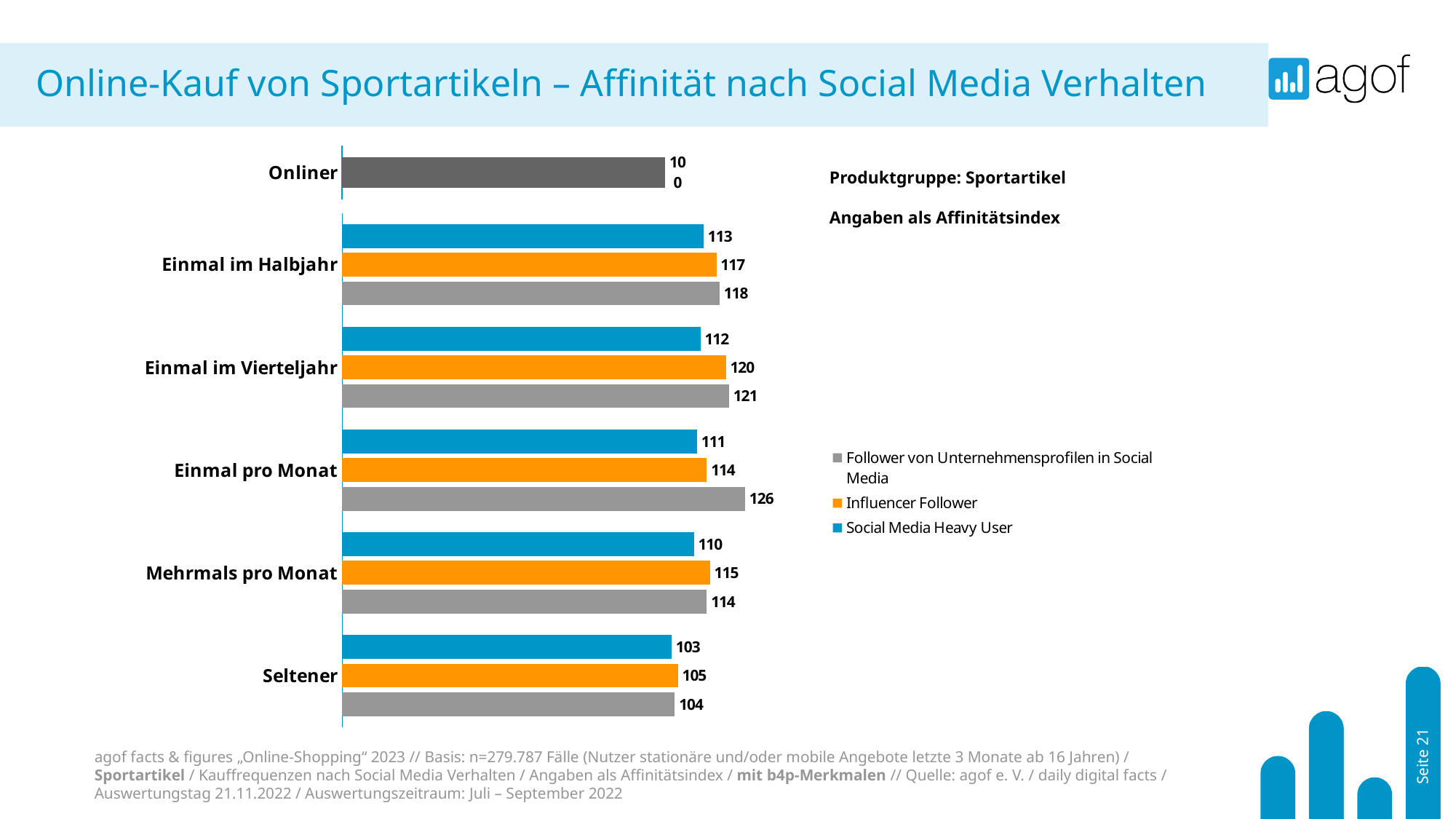
How many series does the legend list? 3 What type of chart is shown on the slide? bar chart What is the difference between the Influencer Follower value and the Social Media Heavy User value in the category Einmal im Vierteljahr? 8 How many categories are shown on the vertical axis of the chart? 6 In the category Mehrmals pro Monat, which is larger: the Influencer Follower value or the Follower von Unternehmensprofilen in Social Media value? Influencer Follower What is the value for Social Media Heavy User in the category Seltener? 103 Which category has the highest value for Follower von Unternehmensprofilen in Social Media? Einmal pro Monat What is the value for Follower von Unternehmensprofilen in Social Media in the category Einmal pro Monat? 126 What is the difference between the Follower von Unternehmensprofilen in Social Media values for Einmal pro Monat and Seltener? 22 Which colour represents the Influencer Follower series in the chart? orange What is the value for Influencer Follower in the category Einmal im Vierteljahr? 120 Which category has the lowest value for Social Media Heavy User? Seltener